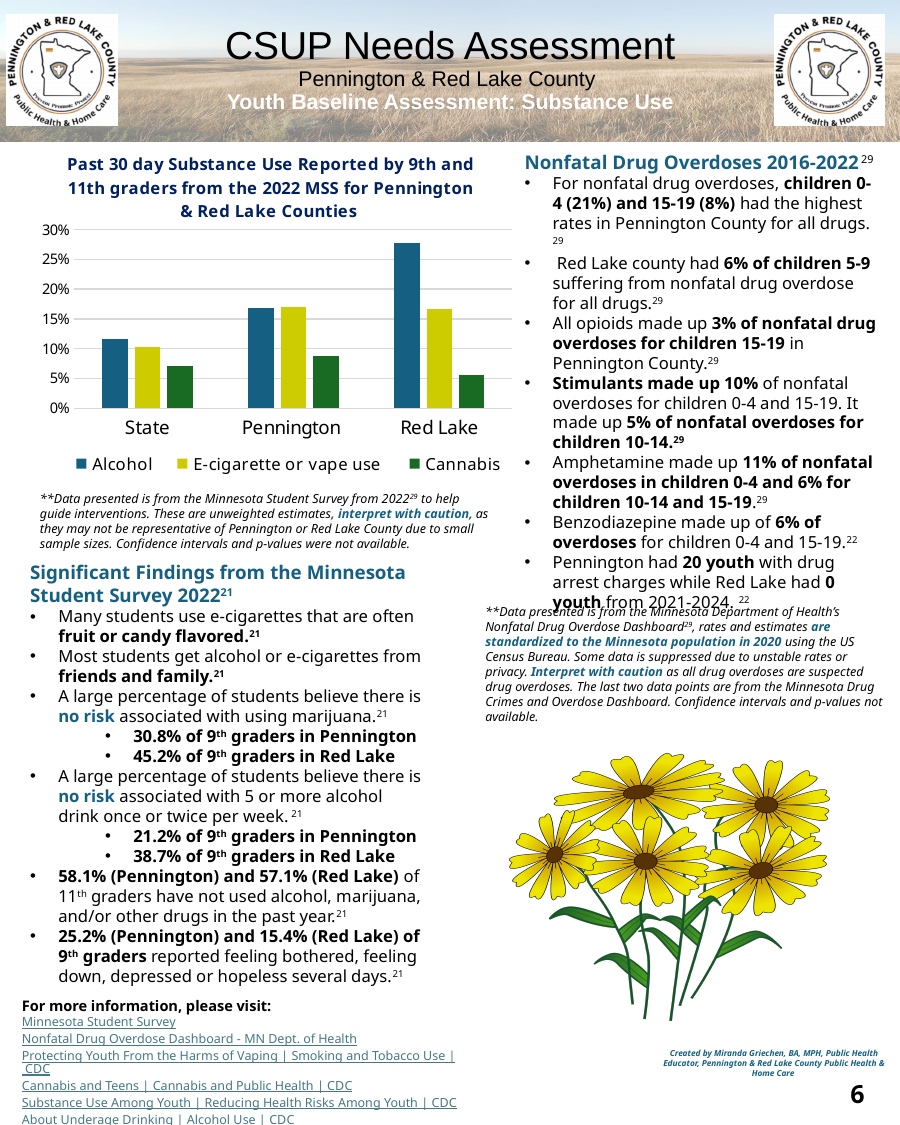
How many categories are shown on the x axis of the chart? 3 Which category has the lowest Cannabis value? Red Lake Is the Alcohol value for Red Lake greater or less than 25%? greater Is the Alcohol value for State greater or less than 10%? greater Which category has the highest Alcohol value? Red Lake Which series is shown in yellow in the chart? E-cigarette or vape use Does the Alcohol value rise or fall moving from State to Pennington to Red Lake? rise For Red Lake, which is larger: Alcohol or E-cigarette or vape use? Alcohol How many series does the chart legend list? 3 What kind of chart is shown on the slide? bar chart Is the E-cigarette or vape use value for Red Lake greater or less than 20%? less